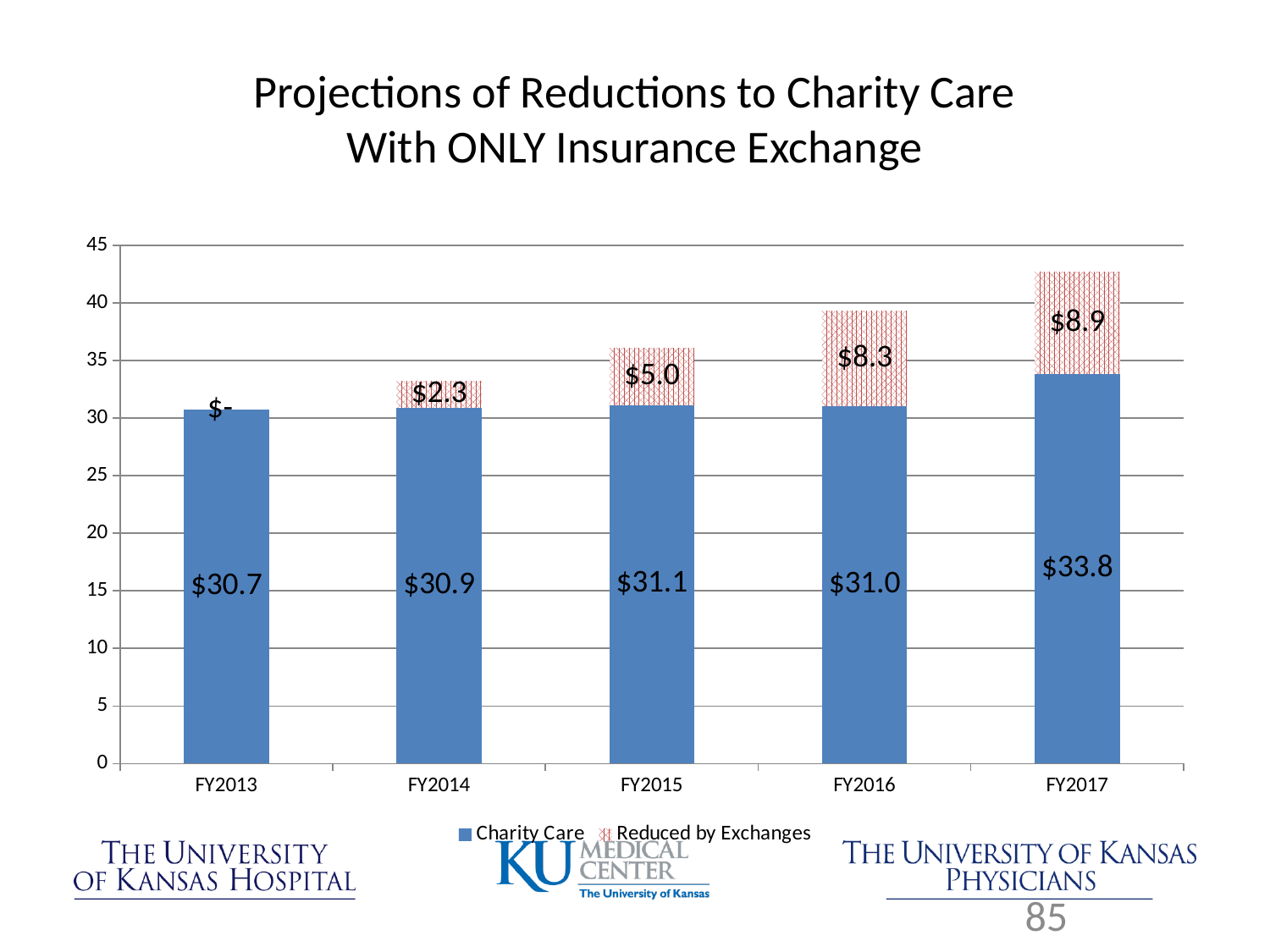
Which is larger, the Charity Care value for FY2015 or for FY2016? FY2015 What is the Reduced by Exchanges value for FY2013? $- How many series does the legend list? 2 Which fiscal year has the lowest Charity Care value? FY2013 What is the Charity Care value for FY2017? $33.8 Do the Reduced by Exchanges values rise or fall from FY2013 to FY2017? Rise Which fiscal year has the highest Reduced by Exchanges value? FY2017 How many fiscal years are shown on the x axis? 5 What is the Reduced by Exchanges value for FY2015? $5.0 What kind of chart is shown on the slide? Stacked bar chart What is the difference between the Reduced by Exchanges values for FY2017 and FY2014? $6.6 What is the total of the stacked bar for FY2016? $39.3